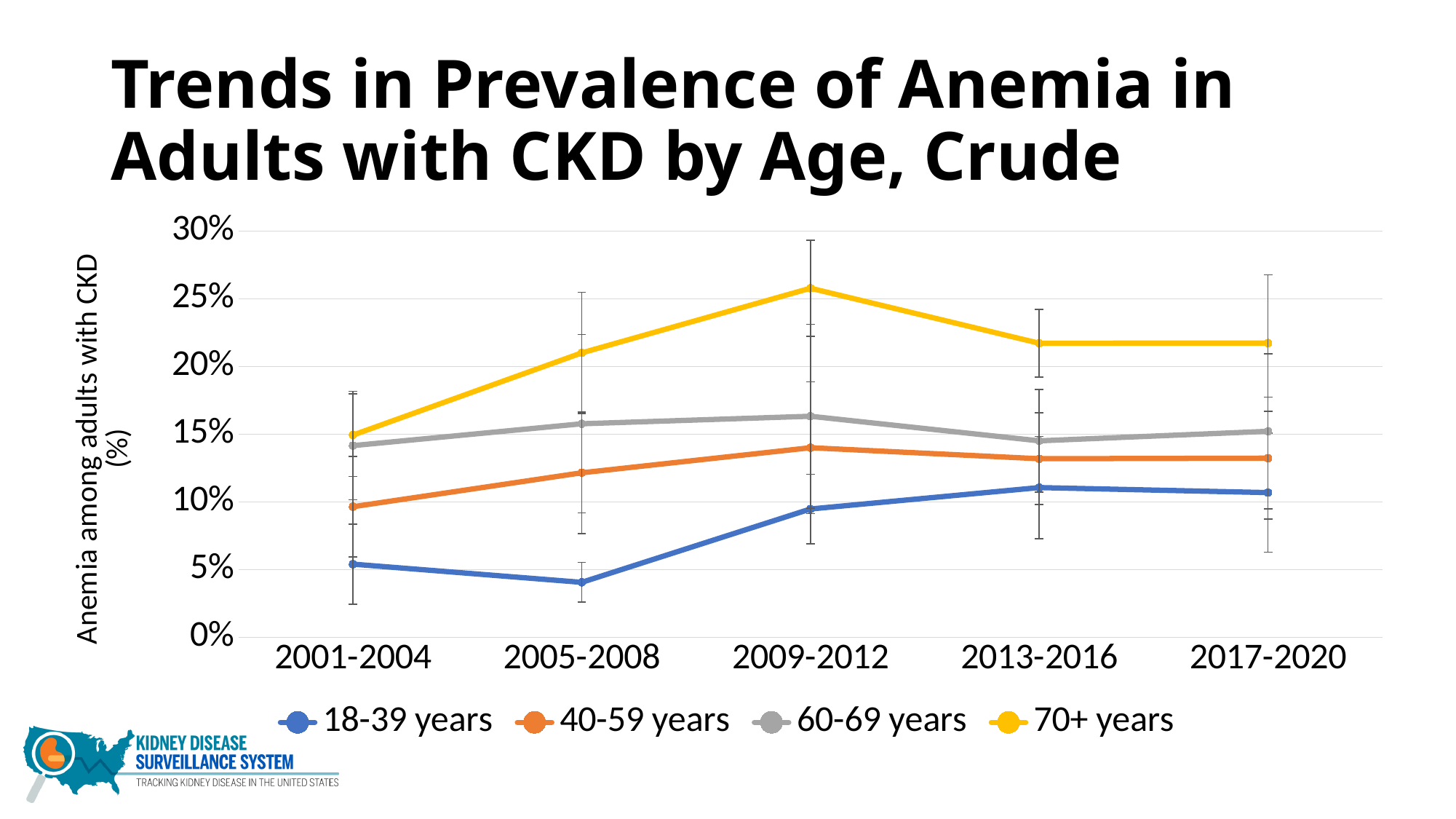
What colour is the line for the 70+ years series? Yellow Is the value for 60-69 years in 2009-2012 greater or less than 15%? greater How many time periods are shown on the x axis? 5 What kind of chart is shown on the slide? Line chart Which age group has the lowest anemia prevalence in 2001-2004? 18-39 years Which age group has the highest anemia prevalence in 2009-2012? 70+ years For the 18-39 years series, which period has the lowest value? 2005-2008 Does the 70+ years series rise or fall from 2001-2004 to 2009-2012? Rise How many series does the legend list? 4 Is the value for 70+ years in 2009-2012 greater or less than 20%? greater For the 70+ years series, which is larger: the value in 2001-2004 or the value in 2009-2012? 2009-2012 Is the value for 18-39 years in 2005-2008 greater or less than 5%? less